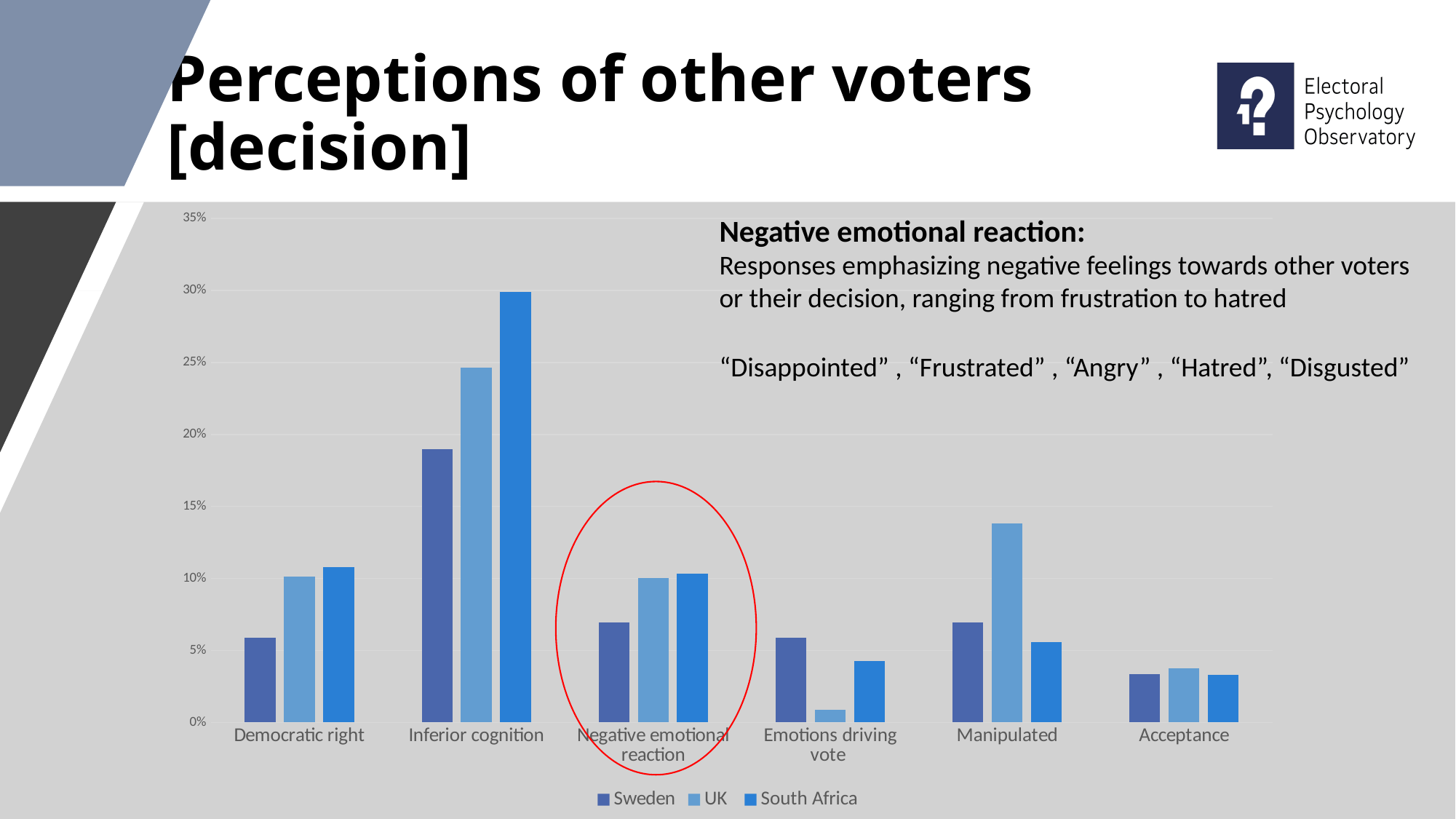
Is the UK value for Emotions driving vote greater or less than 5%? less Is the UK value for Manipulated greater or less than 10%? greater How many categories are shown along the x axis of the chart? 6 Which category has the lowest value for the UK? Emotions driving vote Which category has the highest value for South Africa? Inferior cognition For Manipulated, which series has the larger value, Sweden or UK? UK Which category on the chart is circled in red? Negative emotional reaction For Emotions driving vote, which series has the larger value, Sweden or South Africa? Sweden What kind of chart is shown on the slide? bar chart How many series does the chart's legend list? 3 Is the Sweden value for Inferior cognition greater or less than 15%? greater